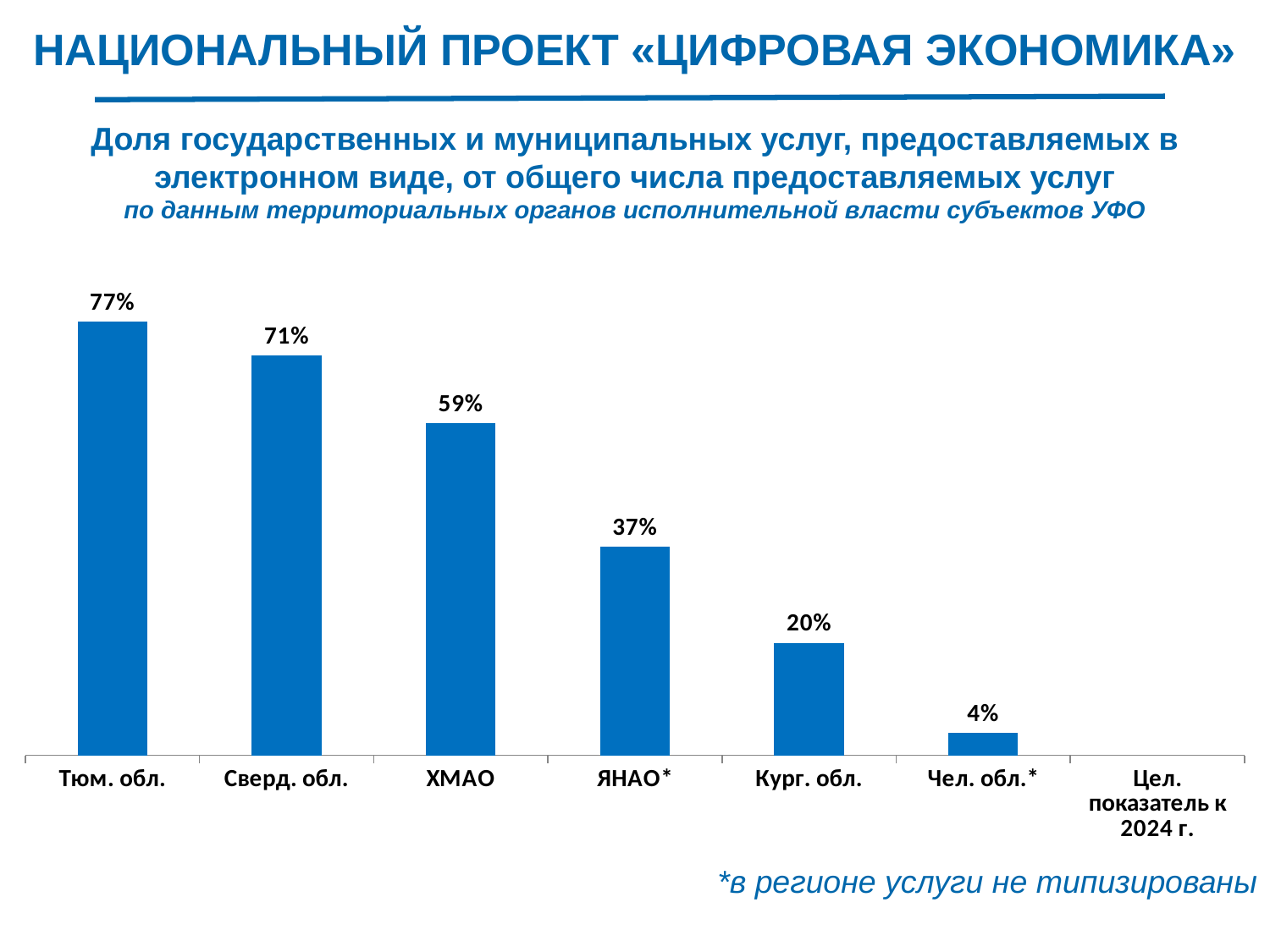
Which region has the highest value? Тюм. обл. What is the value for Чел. обл.*? 4% What is the value for Кург. обл.? 20% What kind of chart is shown on the slide? Bar chart Which is larger, the value for ХМАО or the value for ЯНАО*? ХМАО What is the difference between the values for Тюм. обл. and Сверд. обл.? 6% What is the value for ЯНАО*? 37% What is the value for Сверд. обл.? 71% What is the value for Тюм. обл.? 77% What is the value for ХМАО? 59% How many bars are plotted in the chart? 6 Which region has the lowest plotted value? Чел. обл.*